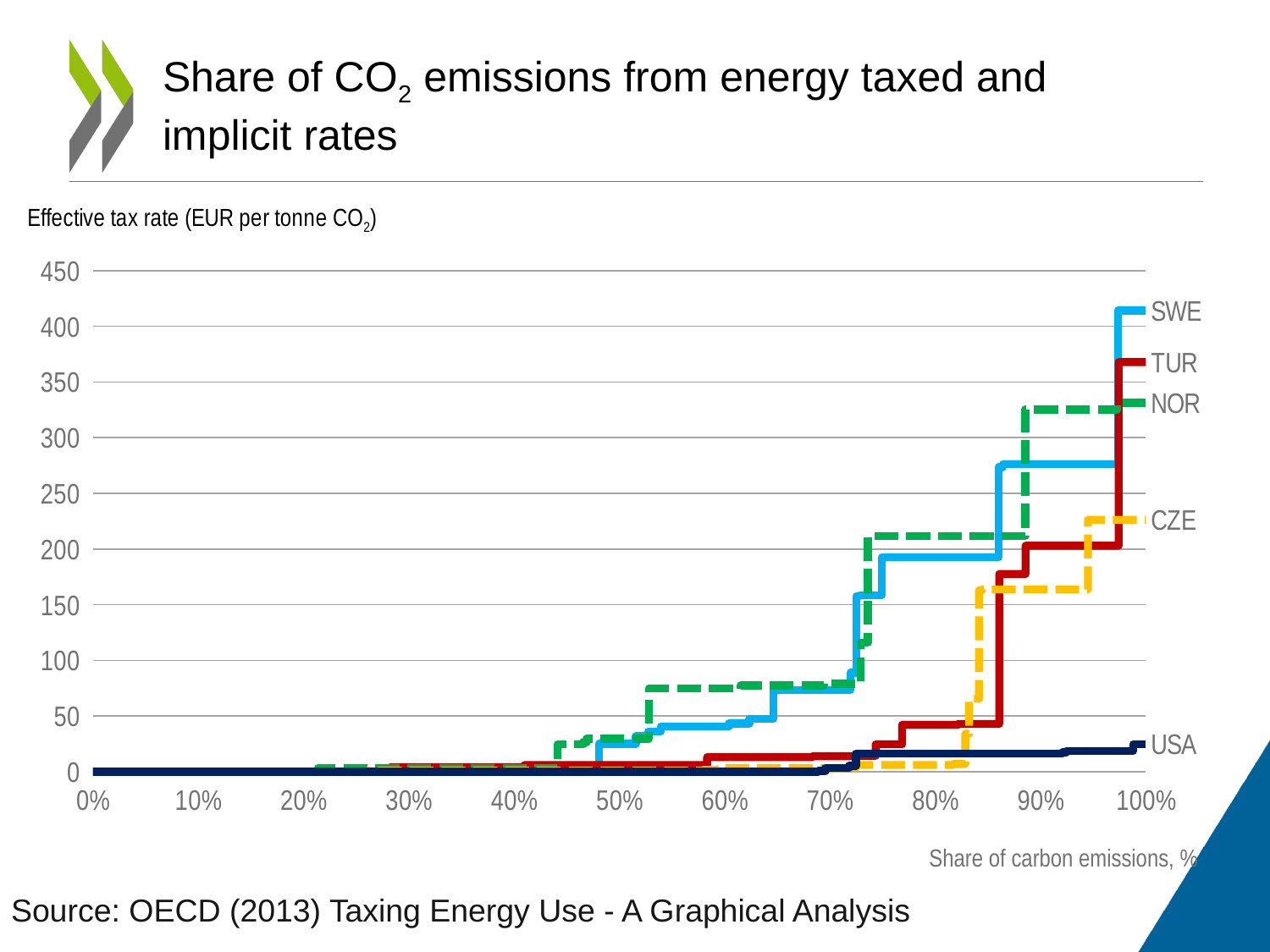
Is the effective tax rate for SWE at 100% share of carbon emissions greater or less than 350? greater Is the effective tax rate for CZE at 80% share of carbon emissions greater or less than 50? less Which country's line stays lowest across the chart? USA Do the effective tax rates rise or fall as the share of carbon emissions increases along the x axis? rise At 100% share of carbon emissions, which has the higher effective tax rate, SWE or TUR? SWE What unit is the effective tax rate on the vertical axis expressed in? EUR per tonne CO2 What kind of chart is shown on the slide? line chart Which country's line reaches the highest effective tax rate at the right end of the chart? SWE How many series (countries) are labelled on the chart? 5 At 90% share of carbon emissions, which has the higher effective tax rate, NOR or SWE? NOR Is the effective tax rate for USA at 100% share of carbon emissions greater or less than 50? less